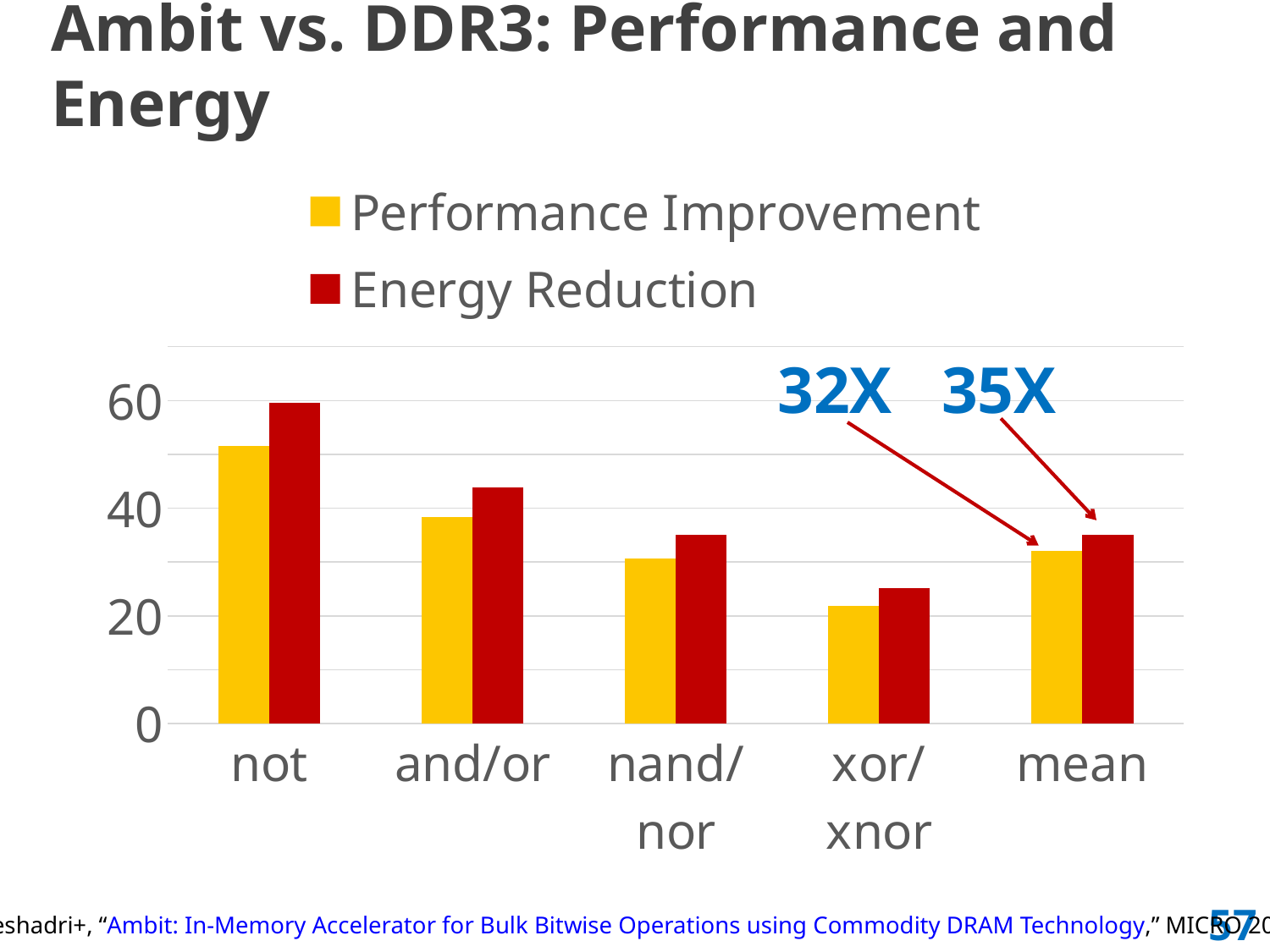
Is the Energy Reduction value for not greater or less than 40? greater Which category has the highest Energy Reduction? not Which is larger for and/or: Performance Improvement or Energy Reduction? Energy Reduction What is the Performance Improvement value for mean? 32X What kind of chart is shown on the slide? bar chart How many series does the legend list? 2 Which colour represents Energy Reduction in the legend? red Do the Performance Improvement values rise or fall from not to xor/xnor? fall Which category has the lowest Performance Improvement? xor/xnor Is the Performance Improvement value for xor/xnor greater or less than 40? less What is the Energy Reduction value for mean? 35X How many categories are shown on the x axis? 5